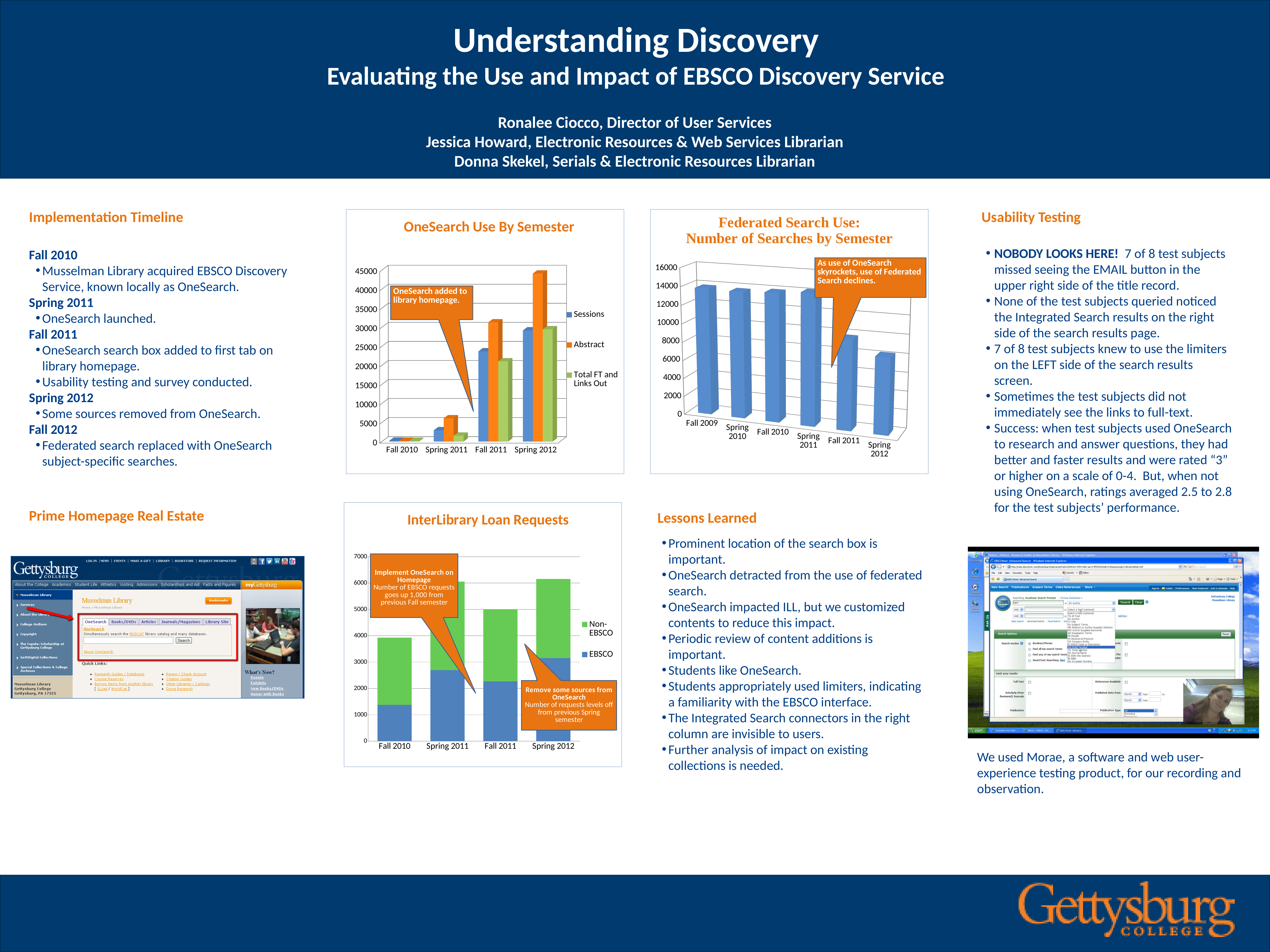
In the Federated Search Use chart, is the value for Fall 2011 greater or less than 10000? less In the InterLibrary Loan Requests chart, is the EBSCO value for Fall 2010 greater or less than 2000? less In the InterLibrary Loan Requests chart, which semester has the tallest stacked bar? Spring 2012 In the OneSearch Use By Semester chart, which semester has the highest Abstract value? Spring 2012 In the OneSearch Use By Semester chart, what kind of chart is shown? bar chart In the OneSearch Use By Semester chart, how many series does the legend list? 3 In the OneSearch Use By Semester chart, is the Abstract value for Spring 2012 greater or less than 40000? greater In the Federated Search Use chart, how many semesters are shown on the x axis? 6 In the OneSearch Use By Semester chart, which is larger in Fall 2011: Abstract or Sessions? Abstract In the Federated Search Use chart, which semester has the lowest number of searches? Spring 2012 In the Federated Search Use chart, do the values generally rise or fall from Fall 2009 to Spring 2012? fall